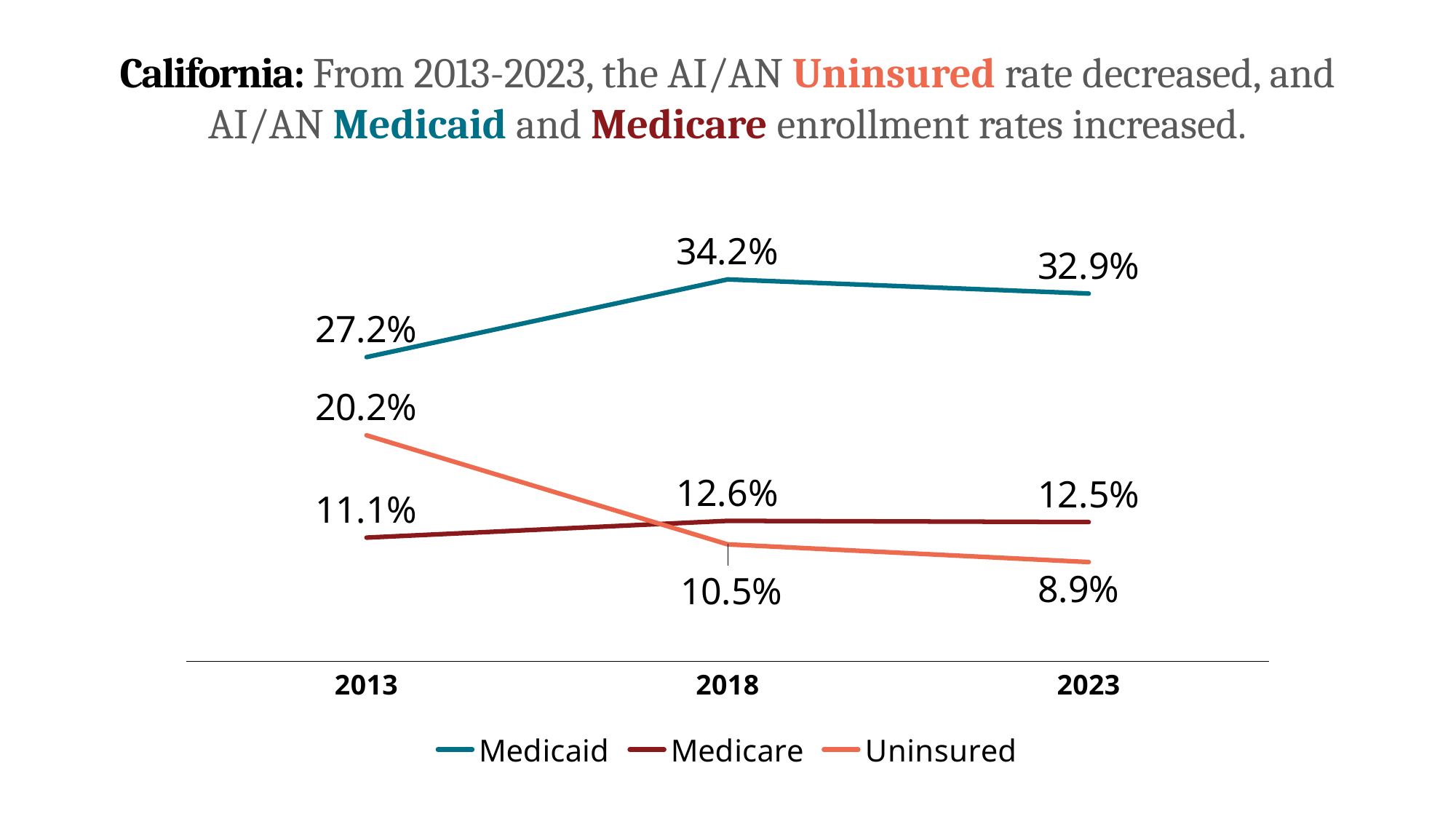
What was the Medicaid enrollment rate in 2013? 27.2% In 2013, which was larger: the Uninsured rate or the Medicare rate? Uninsured What was the Medicare enrollment rate in 2018? 12.6% How many series does the legend list? 3 In which year was the Medicaid rate highest? 2018 Does the Uninsured rate rise or fall from 2013 to 2023? Fall What kind of chart is shown on the slide? Line chart How many years are shown on the x axis? 3 In which year was the Uninsured rate lowest? 2023 What is the difference between the Medicaid rate and the Medicare rate in 2023? 20.4 percentage points What was the Uninsured rate in 2023? 8.9% By how much did the Uninsured rate fall from 2013 to 2023? 11.3 percentage points